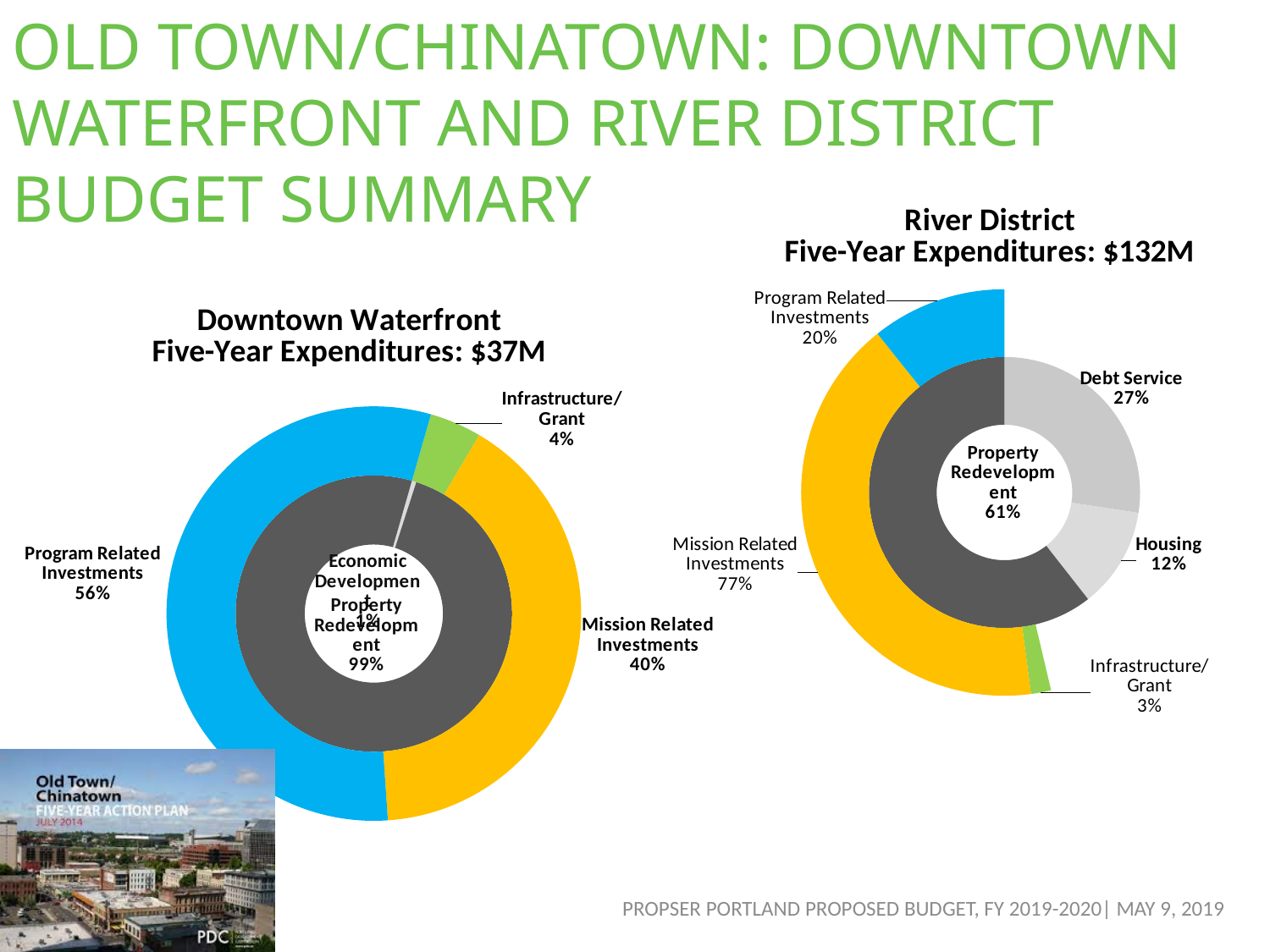
In the Downtown Waterfront chart, which outer-ring category has the largest share? Program Related Investments In the River District chart, what share is Housing? 12% In the Downtown Waterfront chart, what share is Infrastructure/Grant? 4% In the River District chart, which is larger, Property Redevelopment or Debt Service? Property Redevelopment In the Downtown Waterfront chart, what is the difference between the Program Related Investments share and the Mission Related Investments share? 16% In the Downtown Waterfront chart, what share of five-year expenditures is Program Related Investments? 56% In the River District chart, which outer-ring category has the smallest share? Infrastructure/Grant What kind of chart is used for the Downtown Waterfront five-year expenditures? Doughnut chart In the River District chart, what share is Mission Related Investments? 77% What total five-year expenditure amount is given in the River District chart title? $132M In the River District chart, what share is Debt Service? 27% In the Downtown Waterfront chart, what percentage is shown for Property Redevelopment in the inner ring? 99%